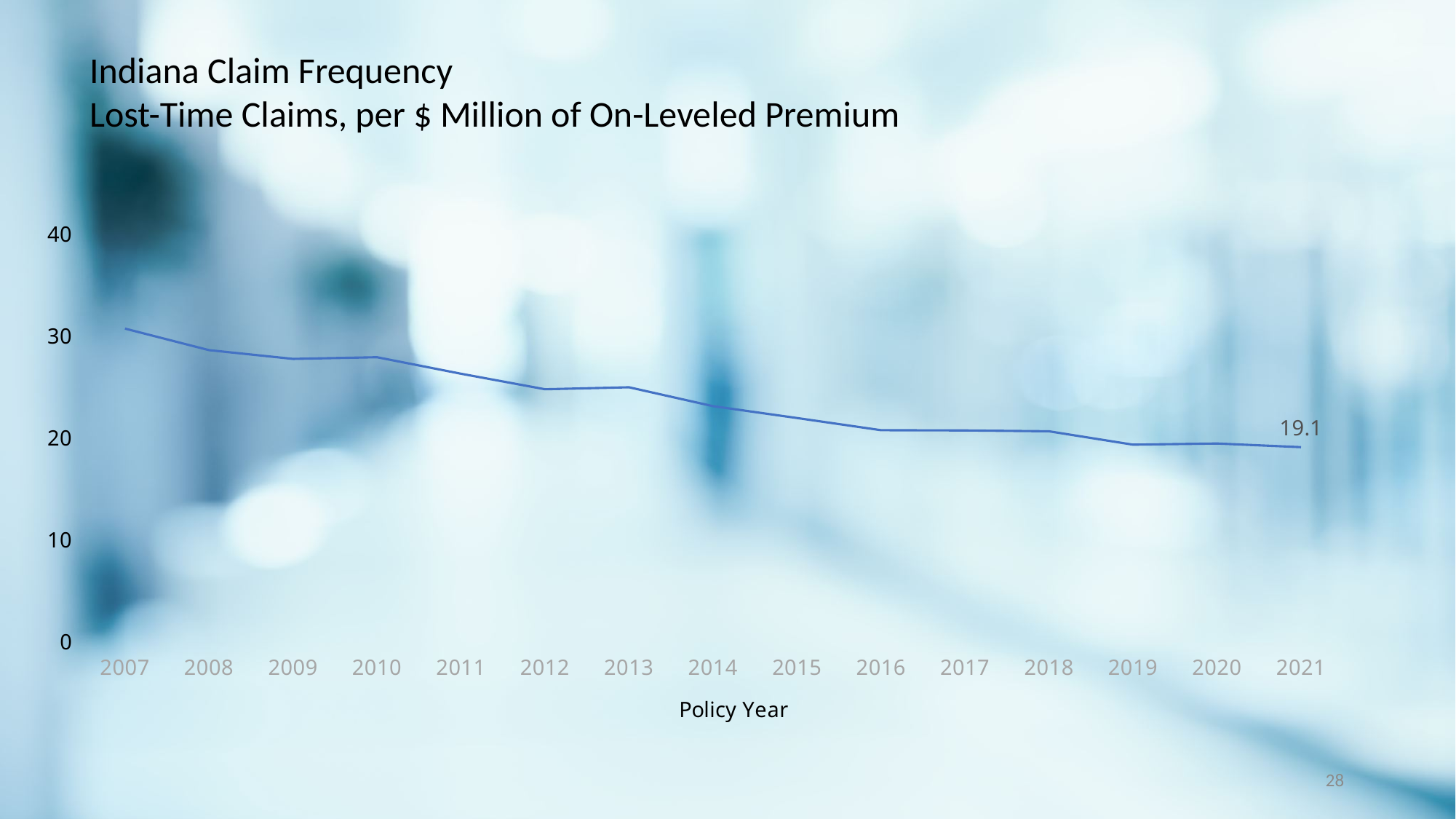
Is the value for 2007 greater or less than 20? greater Is the value for 2013 greater or less than 20? greater Do the values generally rise or fall from 2007 to 2021? fall What kind of chart is shown on the slide? line chart Which is larger, the value for 2007 or the value for 2021? 2007 Which is larger, the value for 2010 or the value for 2014? 2010 How many policy years are plotted on the x axis? 15 Is the value for 2010 greater or less than 30? less Which policy year has the highest claim frequency? 2007 What is the title of the x axis? Policy Year What is the value for 2021? 19.1